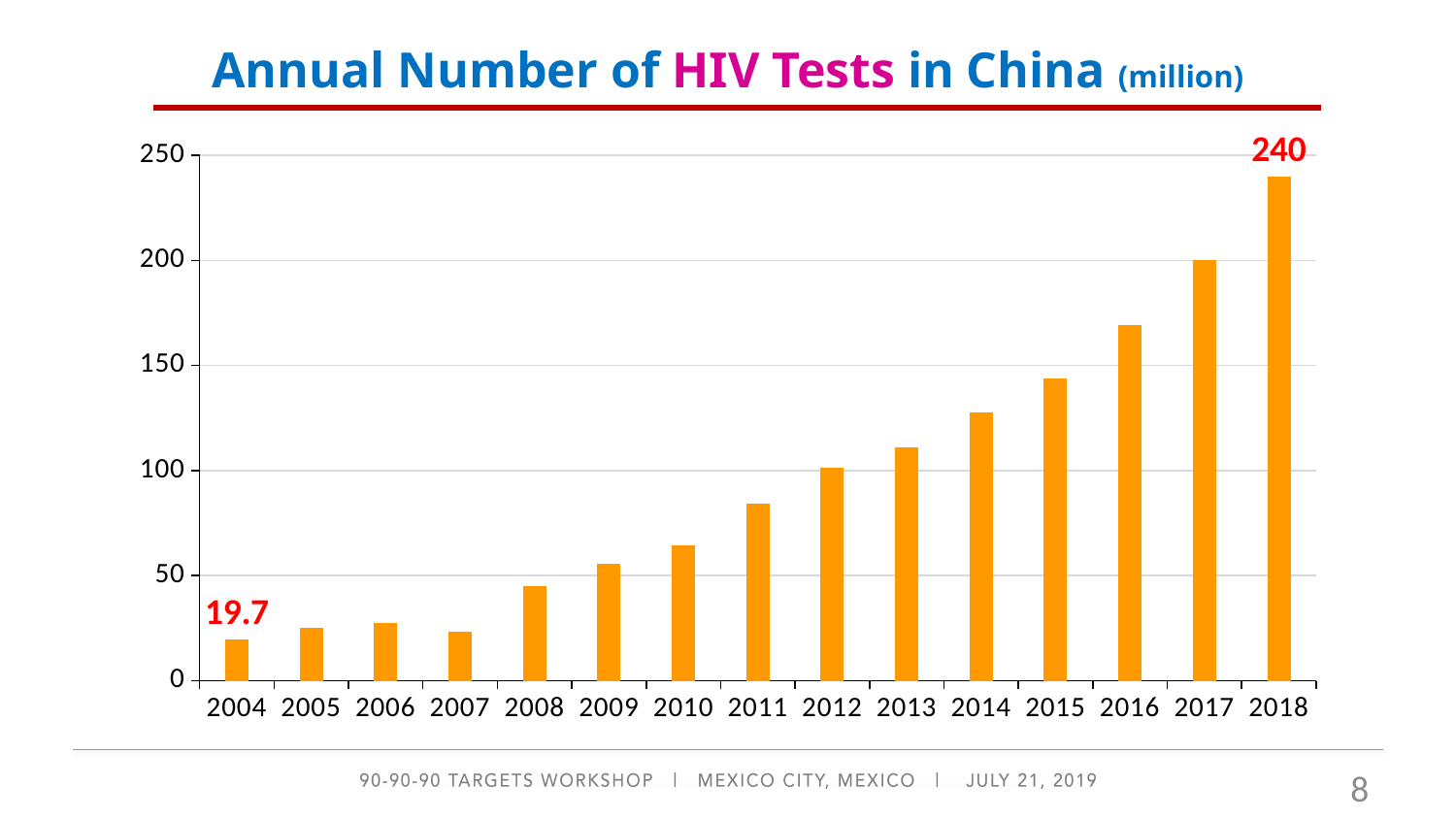
What is the annual number of HIV tests in China for 2018? 240 Do the values generally rise or fall from 2004 to 2018? Rise Which year has the lowest number of HIV tests? 2004 Is the value for 2011 greater or less than 100? less Is the value for 2008 greater or less than 50? less What kind of chart is shown on the slide? Bar chart Which year has more HIV tests, 2015 or 2016? 2016 Is the value for 2014 greater or less than 100? greater What is the annual number of HIV tests in China for 2004? 19.7 How many years are shown on the x axis of the chart? 15 What is the difference between the number of HIV tests in 2018 and in 2004? 220.3 Which year has the highest number of HIV tests? 2018